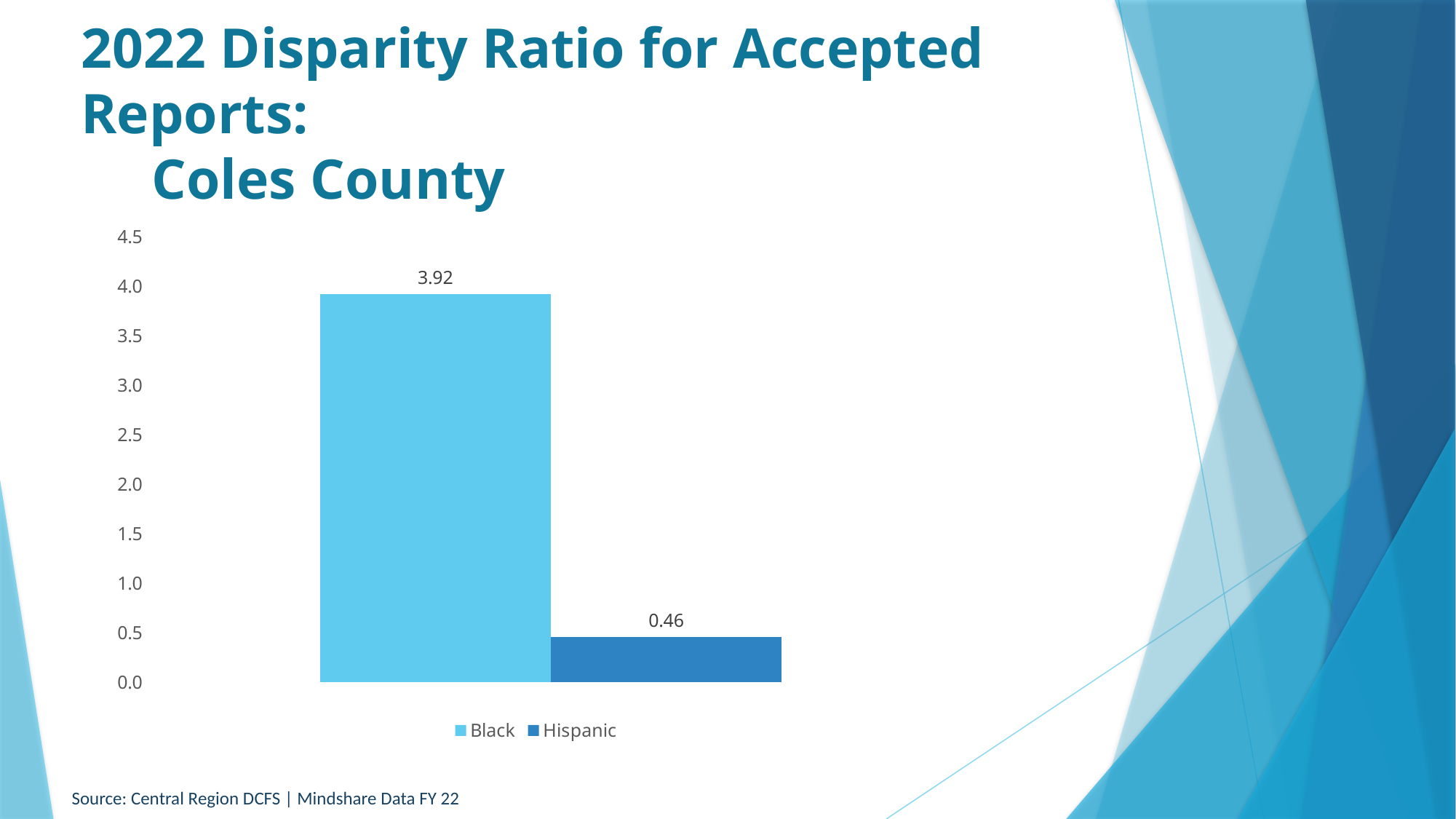
Is the disparity ratio for Black greater or less than 3.5? greater Which group has the highest disparity ratio? Black What is the disparity ratio for Black in the chart? 3.92 Is the disparity ratio for Hispanic greater or less than 1.0? less How many series does the legend list? 2 Which is larger, the disparity ratio for Black or for Hispanic? Black What is the difference between the Black and Hispanic disparity ratios? 3.46 Which group has the lowest disparity ratio? Hispanic What is the highest value shown on the vertical axis? 4.5 What kind of chart is shown on the slide? Bar chart Which county does the chart's title refer to? Coles County What is the disparity ratio for Hispanic in the chart? 0.46